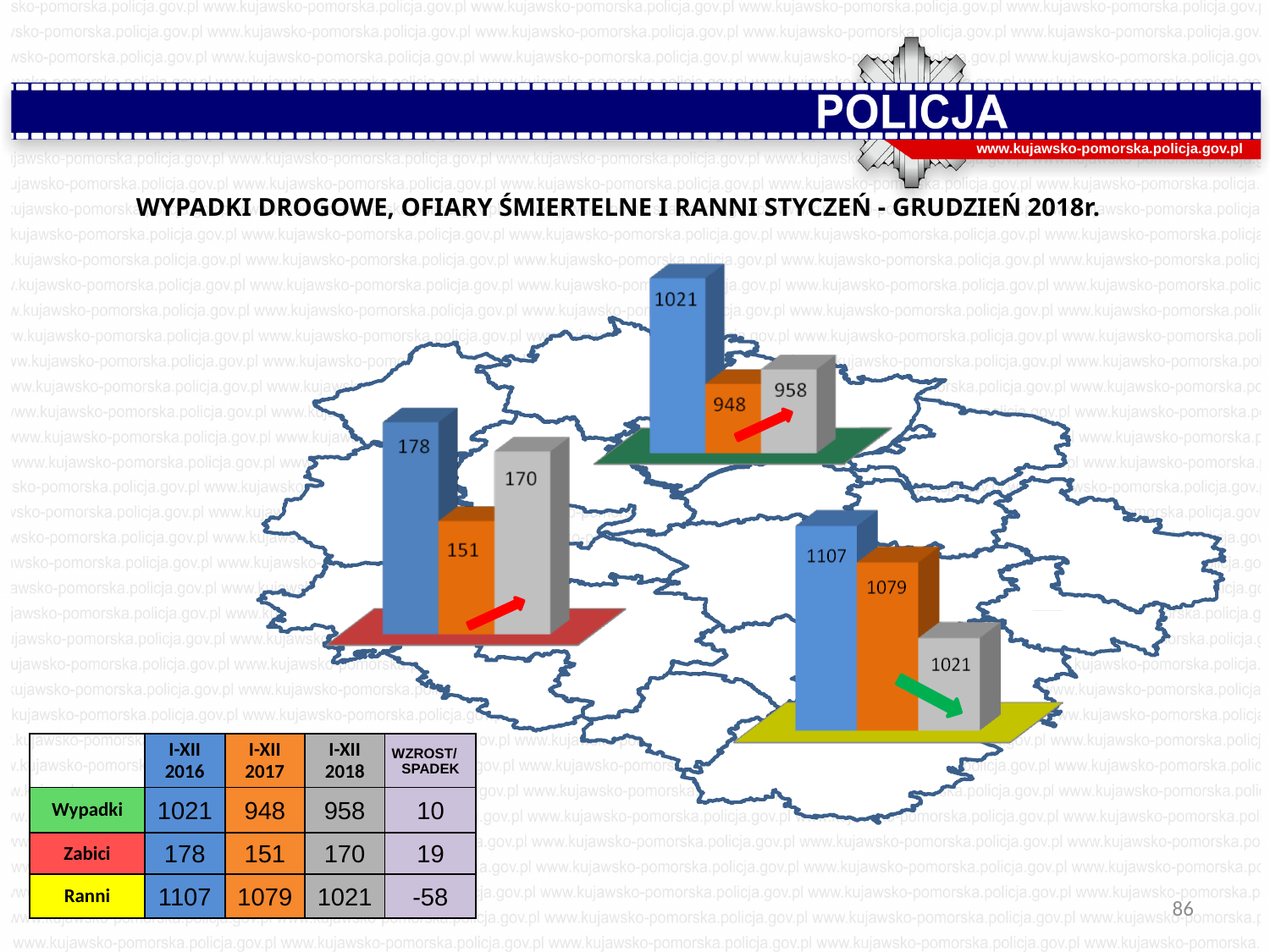
What type of chart is the chart with the red base (left)? bar chart On the chart with the red base (left), what value is shown on the orange bar? 151 On the chart with the yellow base (bottom right), what is the difference between the blue bar and the grey bar? 86 On the chart with the yellow base (bottom right), what value is shown on the grey bar? 1021 On the chart with the red base (left), what is the difference between the grey bar and the orange bar? 19 On the chart with the red base (left), which bar is the highest? the blue bar (178) How many bars does the chart with the yellow base (bottom right) have? 3 On the chart with the green base (top right), which is larger, the orange bar or the grey bar? the grey bar (958) On the chart with the yellow base (bottom right), do the values rise or fall from left to right? fall On the chart with the green base (top right), what value is shown on the blue bar? 1021 On the chart with the green base (top right), which bar is the lowest? the orange bar (948) How many bar charts are placed on the map on this slide? 3